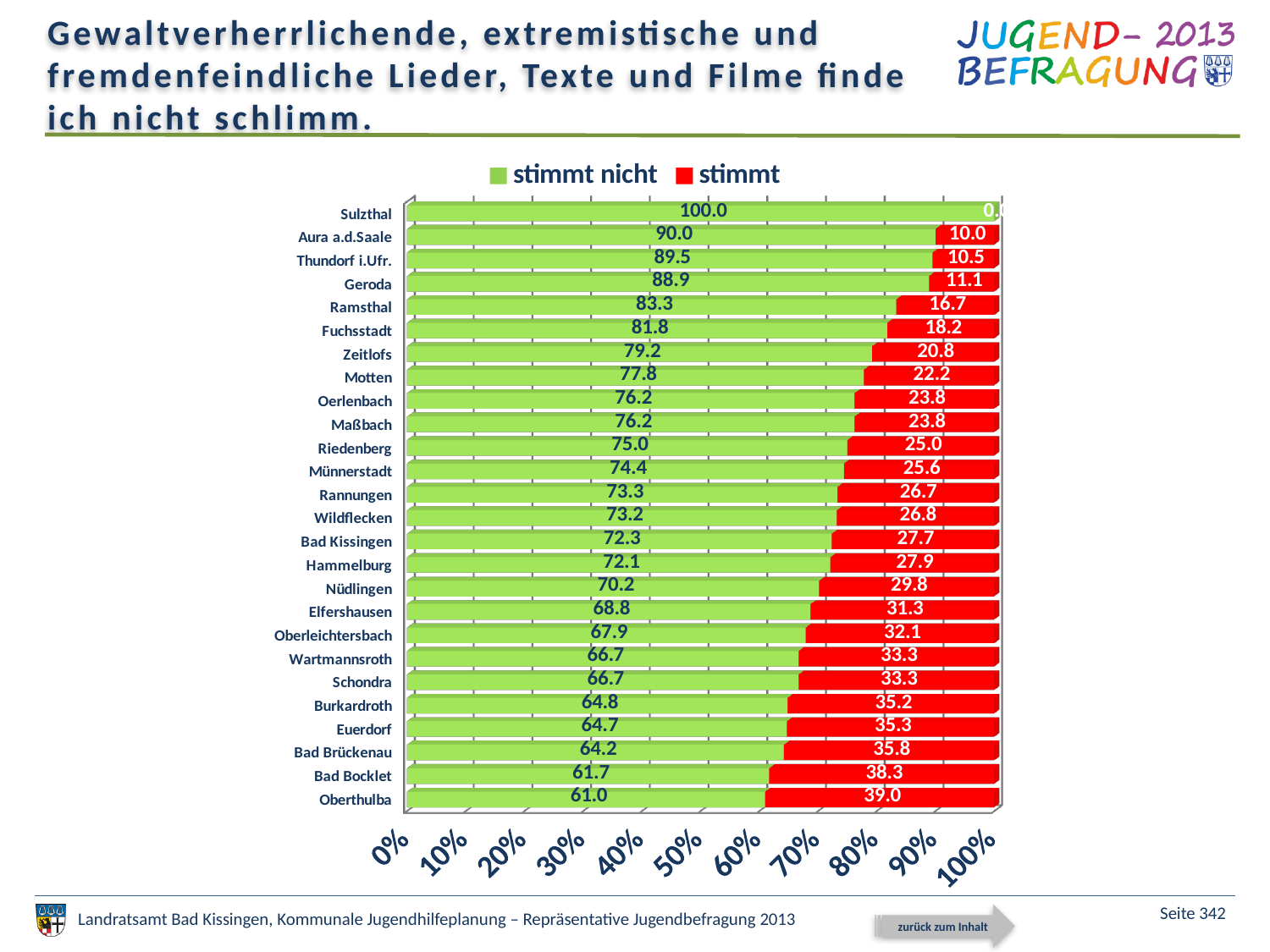
How many series does the legend list? 2 Which municipality has the highest value for "stimmt nicht"? Sulzthal How many municipalities are shown in the chart? 26 What is the value of "stimmt nicht" for Geroda? 88.9 What is the difference between the "stimmt" values for Bad Bocklet and Bad Kissingen? 10.6 Which municipality has the lowest value for "stimmt nicht"? Oberthulba Which has the larger "stimmt nicht" value, Ramsthal or Fuchsstadt? Ramsthal Which municipality has the highest value for "stimmt"? Oberthulba What is the value of "stimmt" for Oberthulba? 39.0 What colour represents the series "stimmt" in the legend? Red What is the value of "stimmt" for Wildflecken? 26.8 What kind of chart is shown on the slide? Stacked bar chart